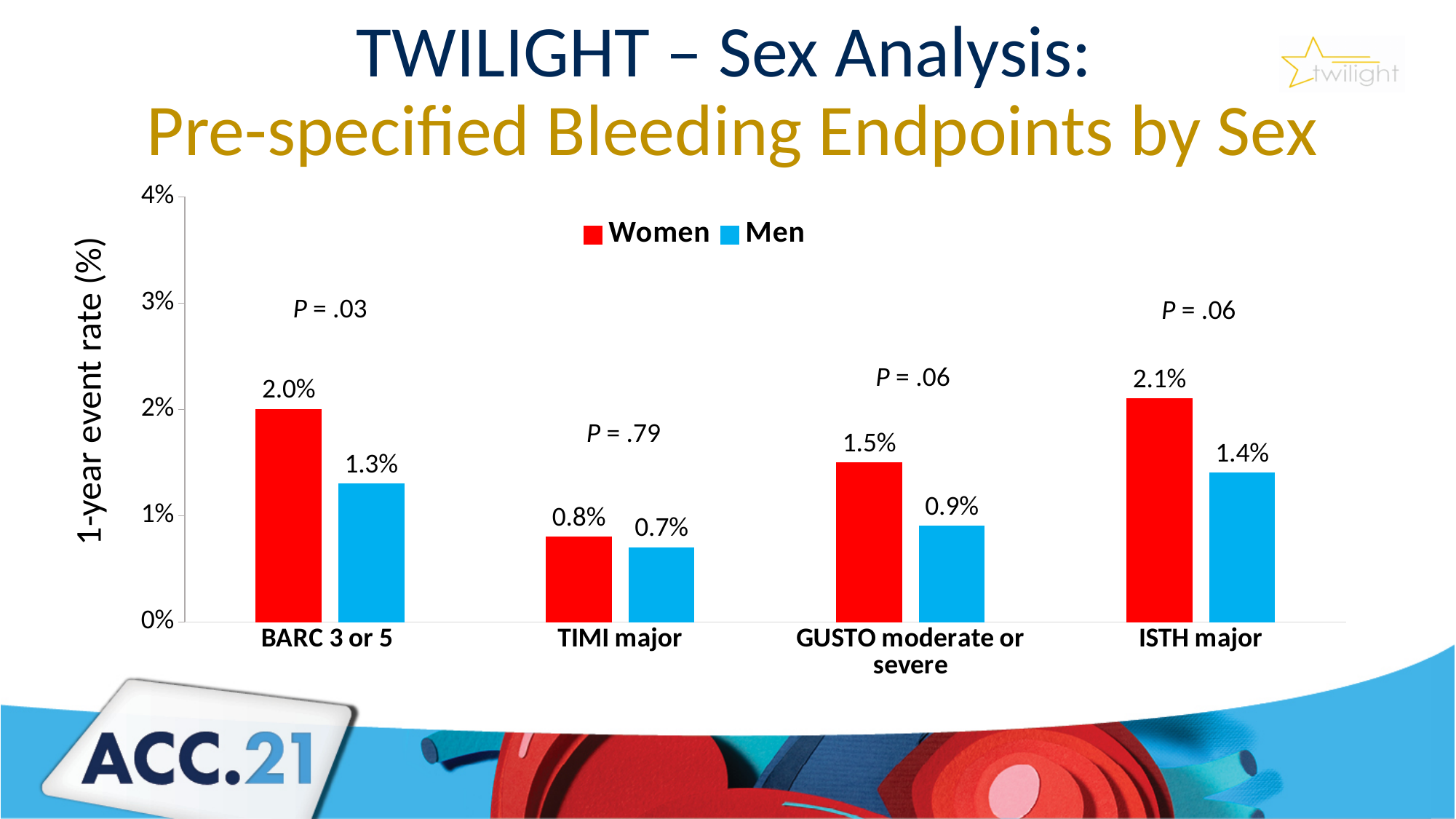
How many series does the legend list? 2 What is the 1-year event rate for Women for BARC 3 or 5? 2.0% What is the 1-year event rate for Men for TIMI major? 0.7% What is the difference between the Women and Men event rates for ISTH major? 0.7% Which bleeding endpoint has the highest event rate for Women? ISTH major How many bleeding endpoint categories are shown on the x axis? 4 For GUSTO moderate or severe, which group has the higher event rate, Women or Men? Women What P value is shown for TIMI major? P = .79 What is the difference between the Women and Men event rates for BARC 3 or 5? 0.7% What is the 1-year event rate for Men for GUSTO moderate or severe? 0.9% What kind of chart is shown on the slide? Bar chart Which bleeding endpoint has the lowest event rate for Men? TIMI major